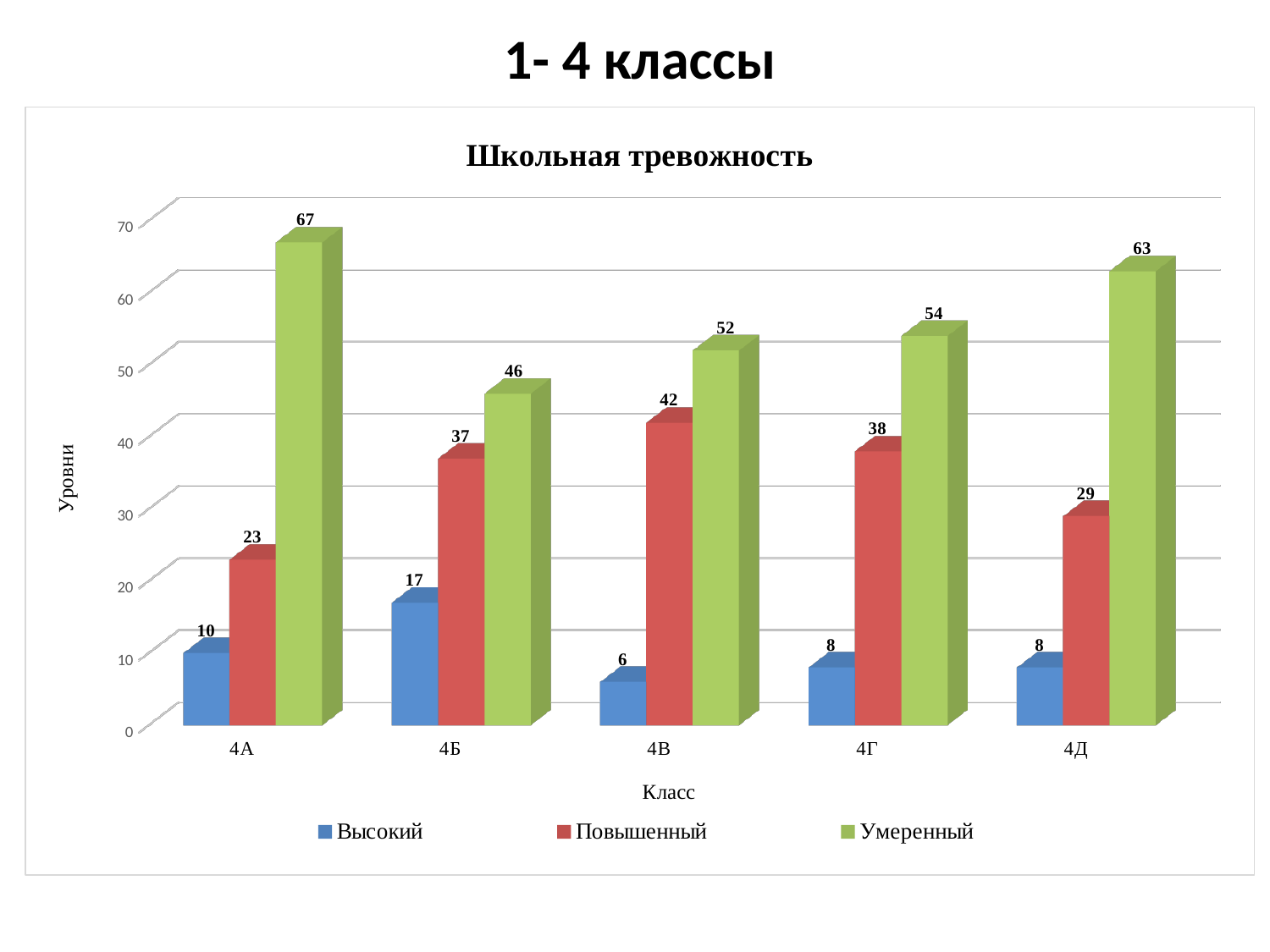
How many classes are shown on the x axis? 5 Which is larger: Повышенный for 4В or Повышенный for 4Г? Повышенный for 4В What kind of chart is this? Bar chart What is the value of Умеренный for class 4Д? 63 Which class has the highest Умеренный value? 4А What is the label of the x axis? Класс What is the value of Высокий for class 4В? 6 What is the title of the chart? Школьная тревожность What is the difference between the Умеренный values for 4А and 4Б? 21 What is the value of Повышенный for class 4Б? 37 How many series does the legend list? 3 Which class has the lowest Высокий value? 4В